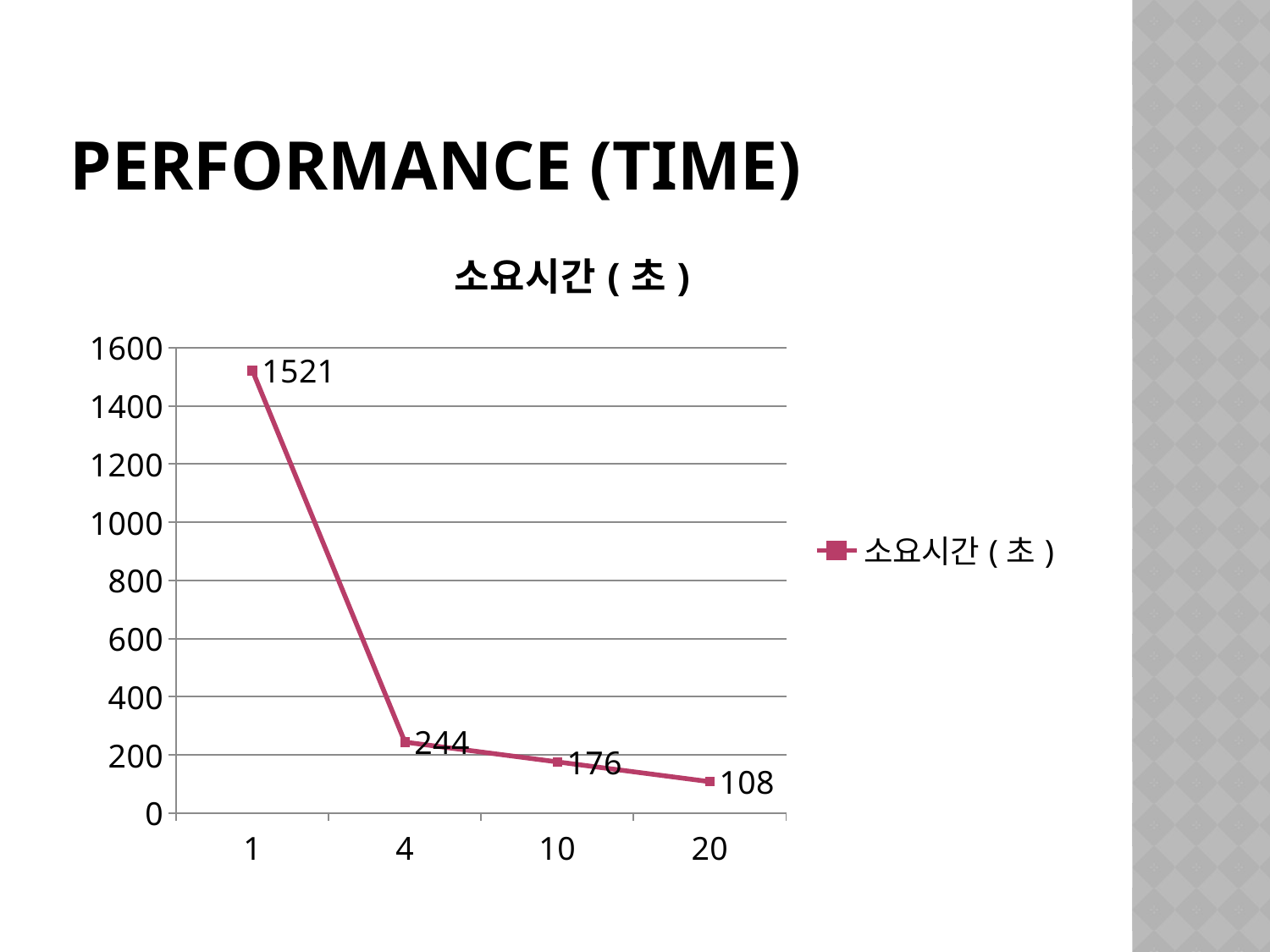
At which x-axis category is the value lowest? 20 What is the value at x = 20? 108 Do the values rise or fall as you move along the x axis from 1 to 20? Fall At which x-axis category is the value highest? 1 What is the difference between the values at x = 1 and x = 4? 1277 Which is larger, the value at x = 4 or the value at x = 10? x = 4 How many data points are plotted on the chart? 4 What is the value at x = 1? 1521 What is the value at x = 10? 176 What is the difference between the values at x = 10 and x = 20? 68 What is the value at x = 4? 244 What kind of chart is shown on the slide? Line chart